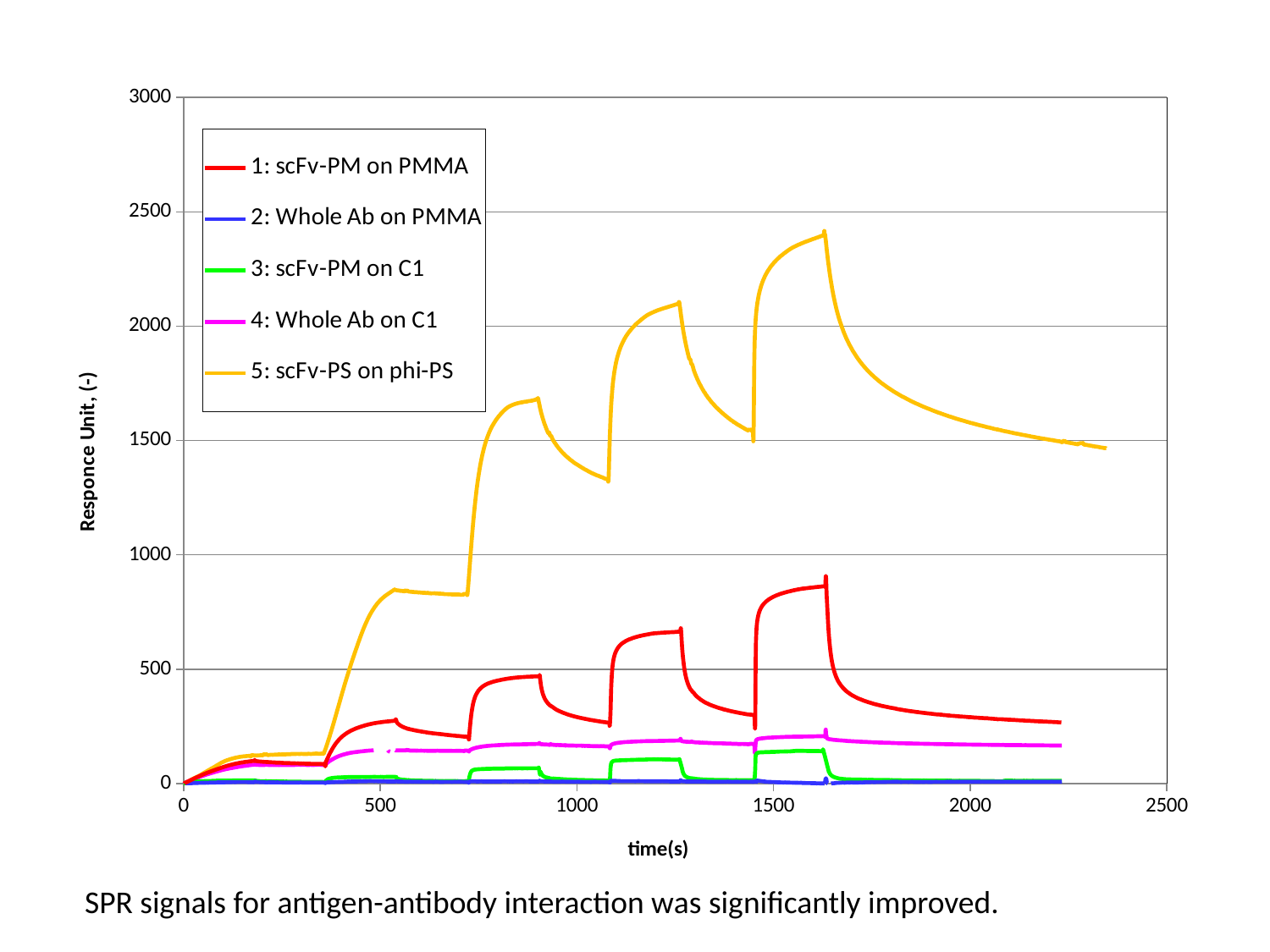
Is the peak value of series 5: scFv-PS on phi-PS greater or less than 2000? greater What is the label of the y axis? Responce Unit, (-) Which series reaches the highest response unit value? 5: scFv-PS on phi-PS Which series stays lowest across the whole time range? 2: Whole Ab on PMMA Is the peak value of series 1: scFv-PM on PMMA greater or less than 1000? less What kind of chart is shown on the slide? line chart At time 2000 s, which is higher: series 1: scFv-PM on PMMA or series 4: Whole Ab on C1? 1: scFv-PM on PMMA How many series does the legend list? 5 Is the value of series 5: scFv-PS on phi-PS at time 2000 s greater or less than 1000? greater Does the value of series 5: scFv-PS on phi-PS rise or fall between about 1650 s and 2300 s? fall What is the legend entry for the yellow line? 5: scFv-PS on phi-PS